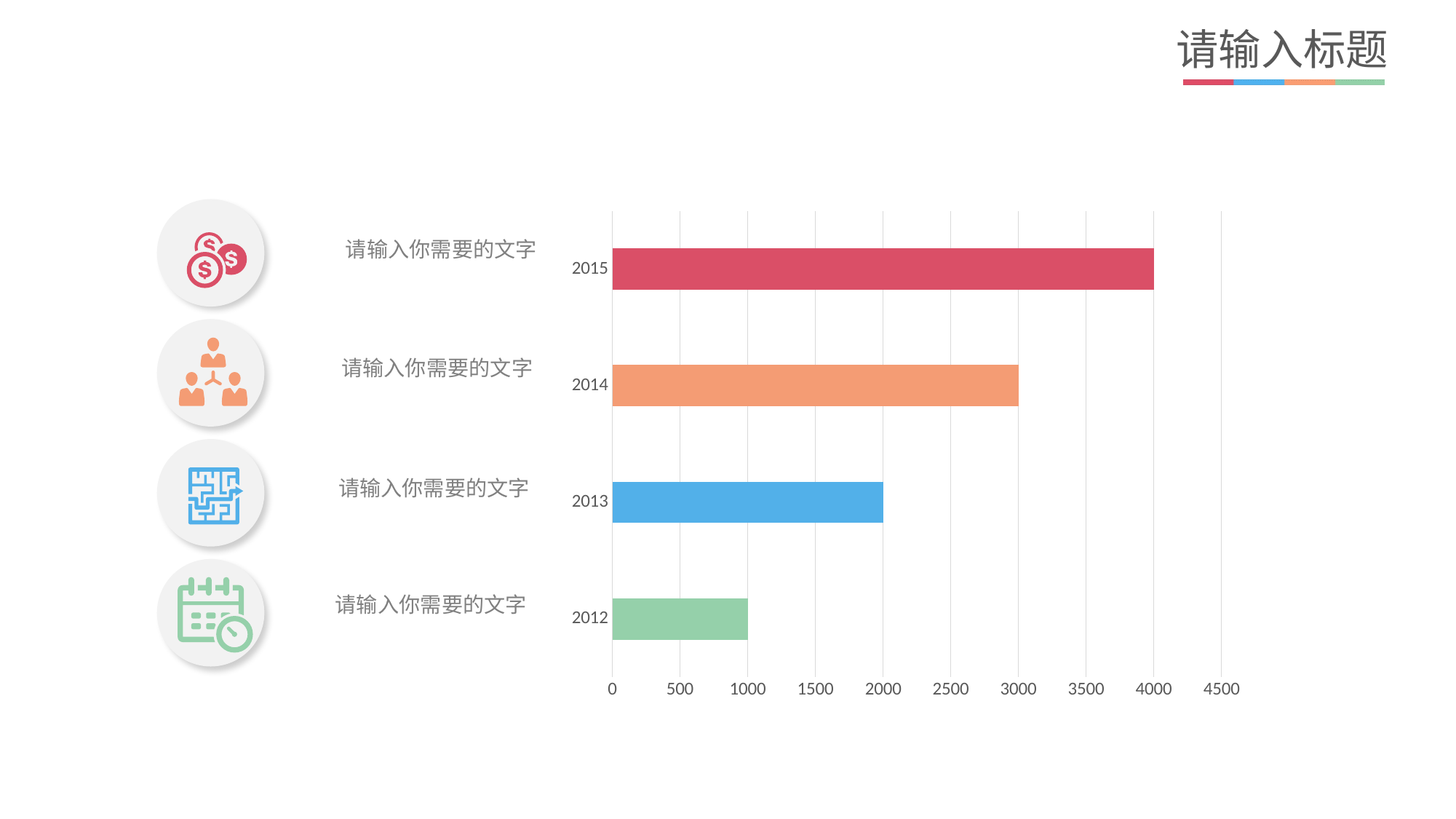
Is the value for 2014 greater or less than 2500? greater How many categories does the bar chart show? 4 What is the value for 2013? 2000 What is the value for 2015? 4000 What kind of chart is shown on the slide? bar chart What is the difference between the values for 2015 and 2013? 2000 Which year has the highest value? 2015 What is the value for 2014? 3000 What is the value for 2012? 1000 What colour is the bar for 2013? blue Which is larger, the value for 2014 or the value for 2012? 2014 Which year has the lowest value? 2012